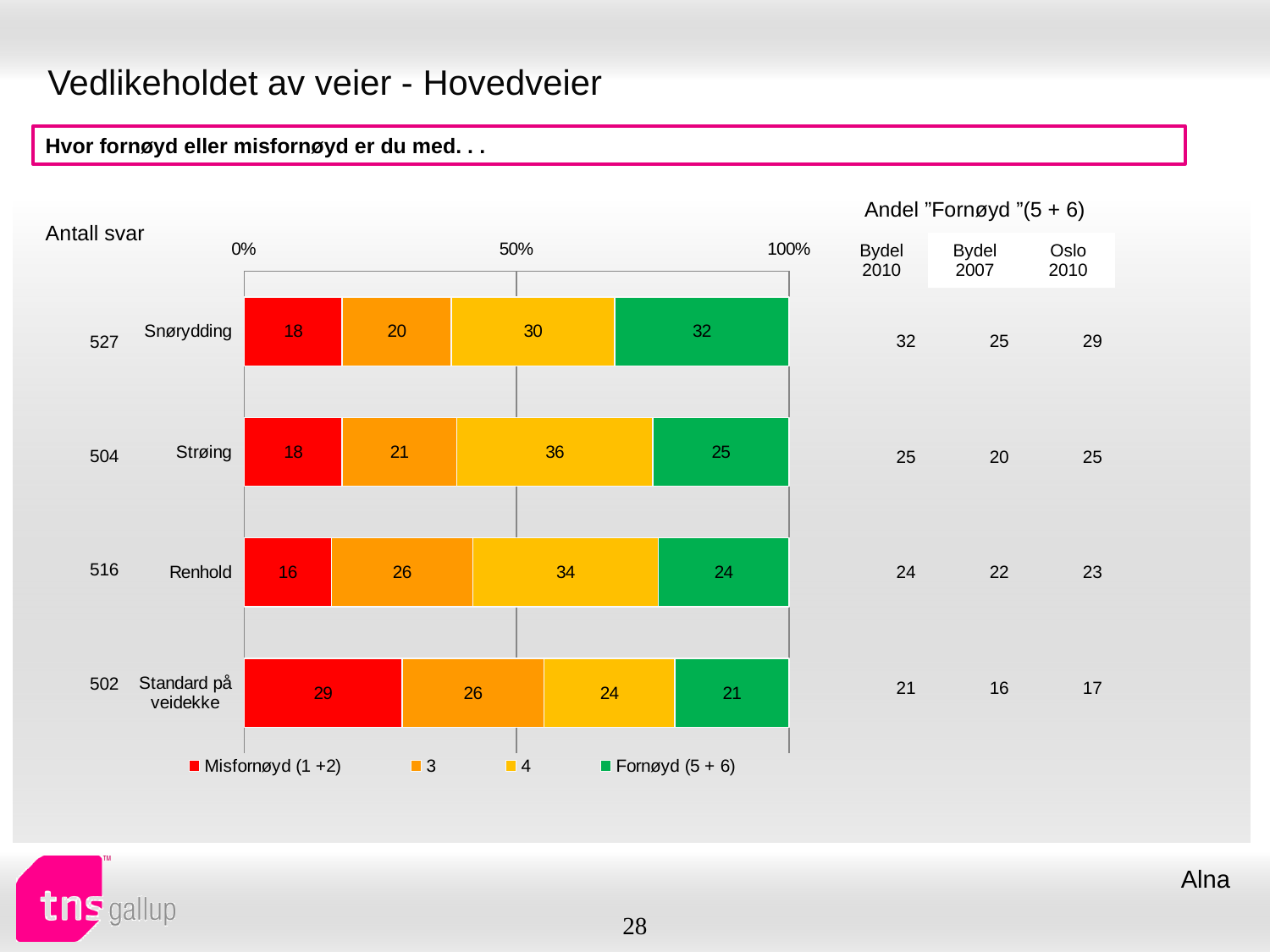
What is the total of the stacked bar for Strøing? 100 What is the value of the '4' segment for Strøing? 36 What kind of chart is shown on the slide? Stacked bar chart How many series does the legend list? 4 Which category has the lowest Misfornøyd (1 +2) value? Renhold What is the value of the '3' segment for Renhold? 26 What is the difference between the Fornøyd (5 + 6) values for Snørydding and Standard på veidekke? 11 Which is larger: the '4' segment for Strøing or the '4' segment for Renhold? Strøing Which category has the highest Fornøyd (5 + 6) value? Snørydding What is the value of the Fornøyd (5 + 6) segment for Snørydding? 32 How many categories are shown in the bar chart? 4 What is the value of the Misfornøyd (1 +2) segment for Standard på veidekke? 29